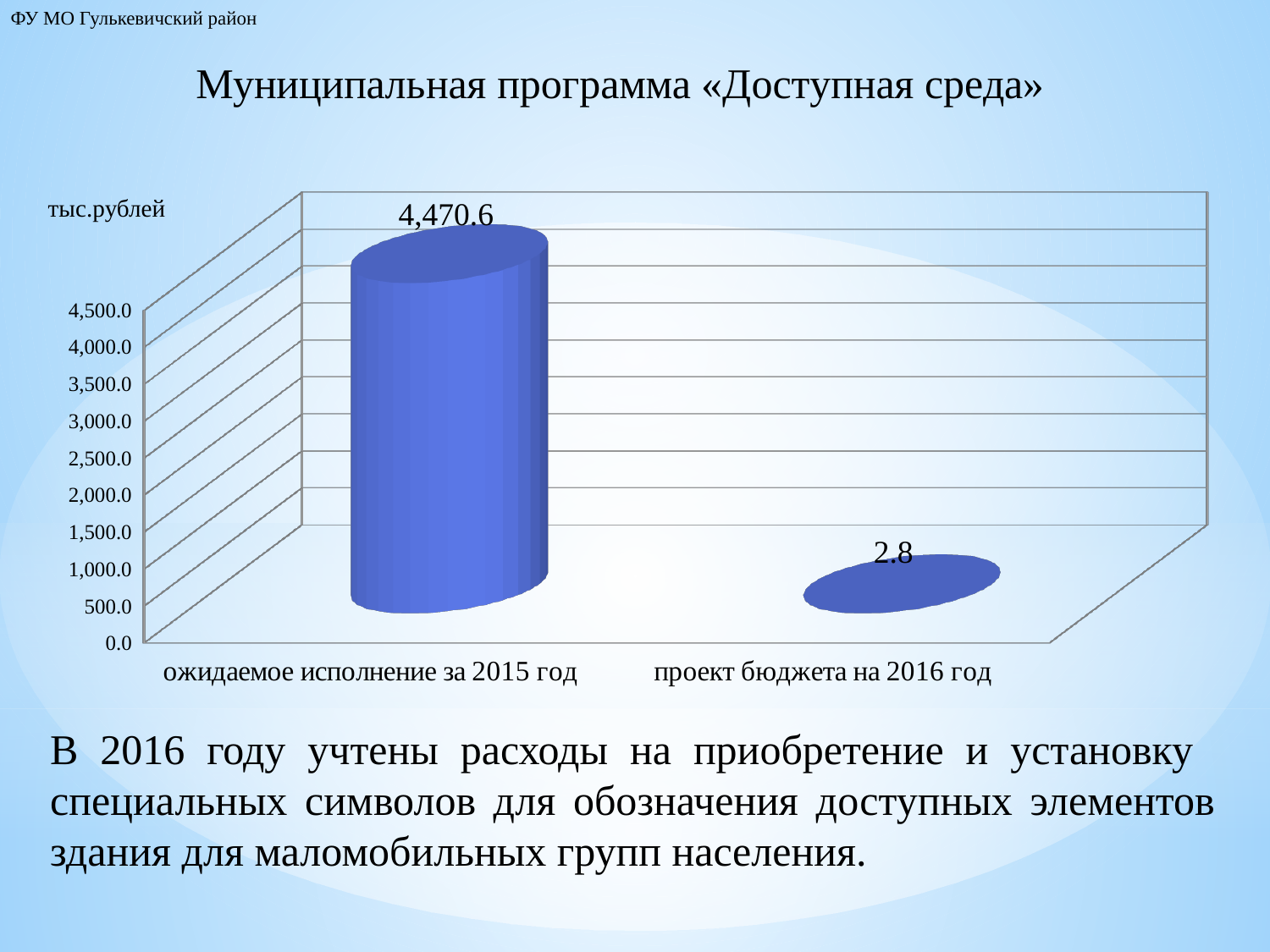
What is the value for «ожидаемое исполнение за 2015 год»? 4,470.6 Do the values rise or fall from the 2015 category to the 2016 category? fall What is the difference between the value for 2015 (ожидаемое исполнение) and the value for 2016 (проект бюджета)? 4,467.8 Is the value for «ожидаемое исполнение за 2015 год» greater or less than 4,000.0? greater Which category has the lowest value? проект бюджета на 2016 год What is the value for «проект бюджета на 2016 год»? 2.8 In what units are the chart values given? тыс.рублей Which category has the highest value? ожидаемое исполнение за 2015 год How many categories are shown on the chart? 2 What kind of chart is shown on the slide? bar chart Is the value for «проект бюджета на 2016 год» greater or less than 500.0? less Which is larger: the value for «ожидаемое исполнение за 2015 год» or for «проект бюджета на 2016 год»? ожидаемое исполнение за 2015 год